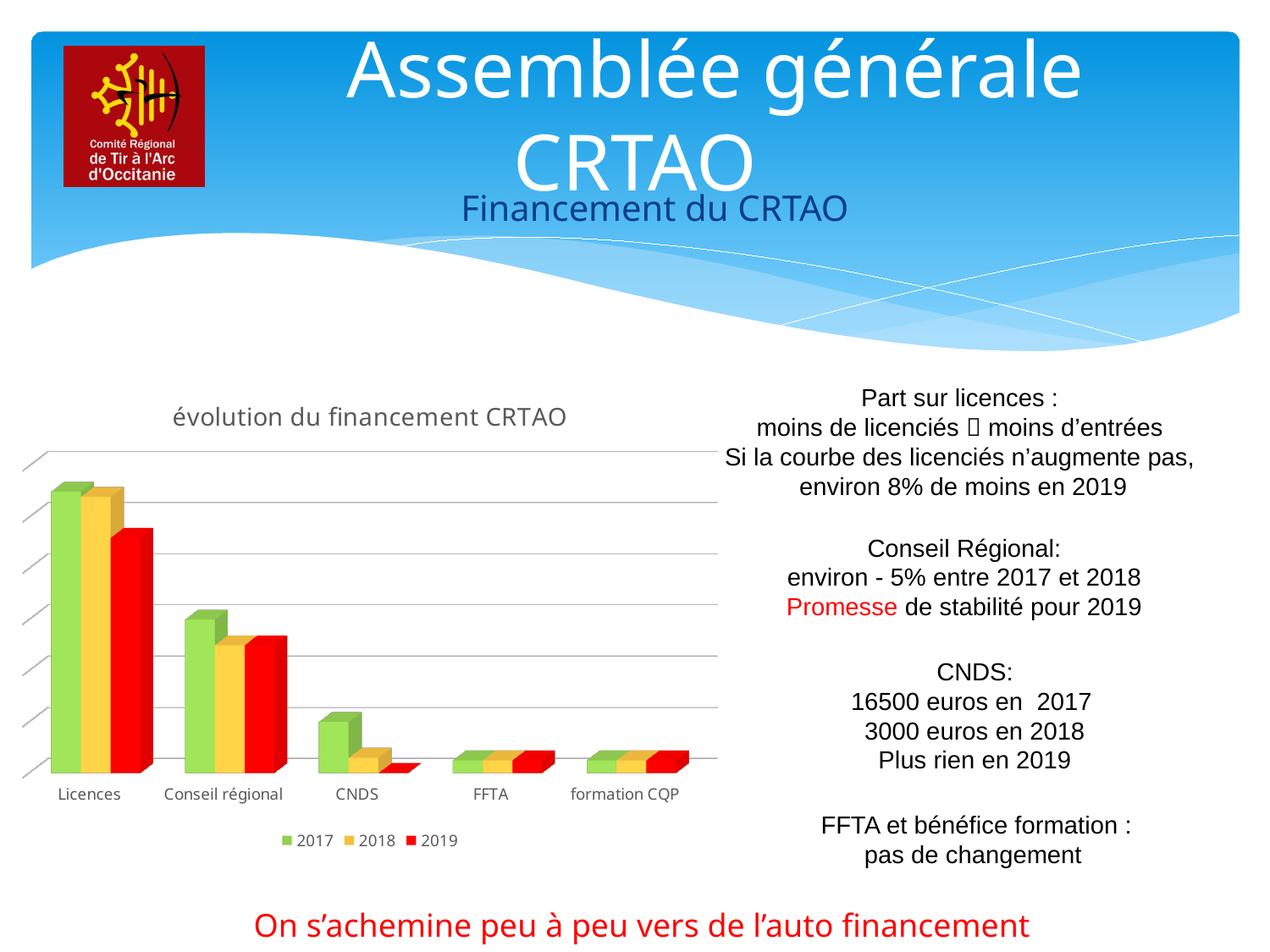
How many series does the chart legend list? 3 Do the CNDS values rise or fall from 2017 to 2019? fall Do the Licences values rise or fall from 2017 to 2019? fall For the Licences category, which year has the highest bar? 2017 Which category has the highest bars in the chart? Licences For the CNDS category, which year has the lowest bar? 2019 Which years are listed in the chart legend? 2017, 2018, 2019 Which is larger in 2017: Licences or Conseil régional? Licences Which is larger: CNDS in 2017 or Conseil régional in 2019? Conseil régional in 2019 What is the title of the chart? évolution du financement CRTAO How many categories are shown on the x axis of the chart? 5 What kind of chart is shown on the slide? bar chart